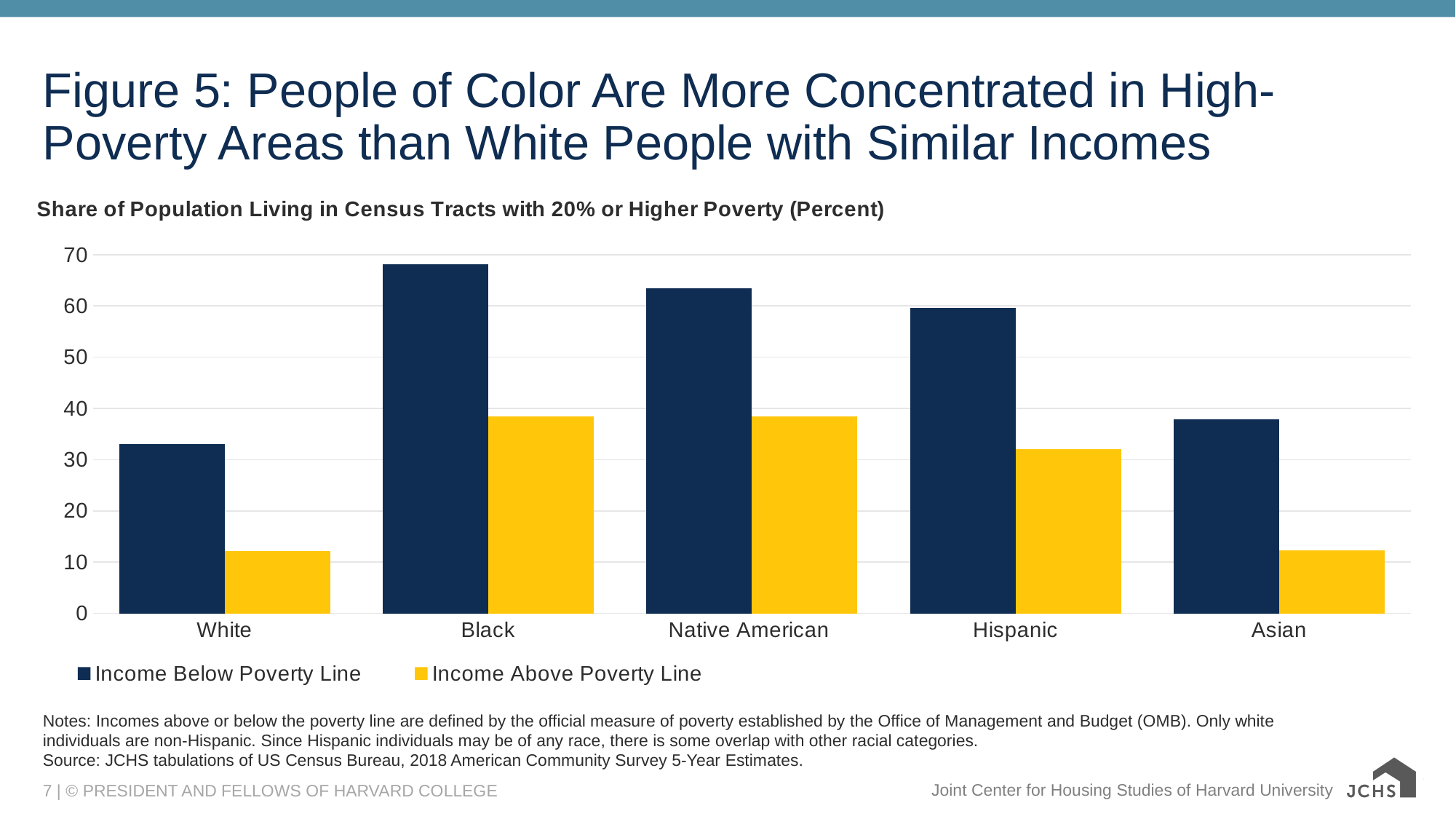
How many series does the legend list? 2 Which is larger for Asian: Income Below Poverty Line or Income Above Poverty Line? Income Below Poverty Line What kind of chart is shown on the slide? bar chart Is the Income Above Poverty Line value for Hispanic greater or less than 30? greater Which category has the lowest value for Income Below Poverty Line? White Is the Income Below Poverty Line value for Asian greater or less than 40? less Is the Income Below Poverty Line value for Black greater or less than 60? greater Which category has the highest value for Income Below Poverty Line? Black Which is larger: the Income Below Poverty Line value for Native American or for Hispanic? Native American What colour are the bars for Income Above Poverty Line? yellow How many racial/ethnic categories are shown on the x axis? 5